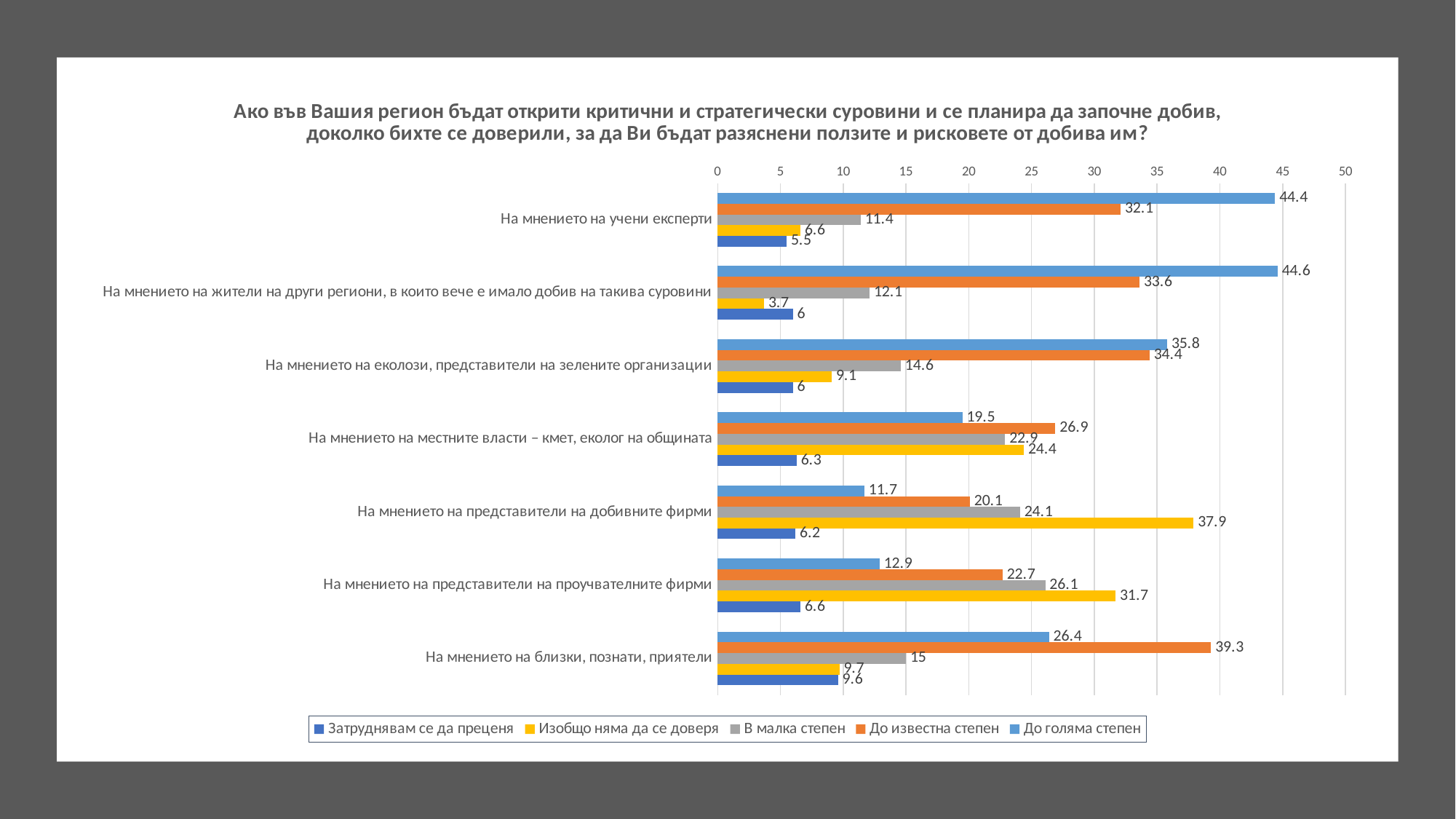
Which category has the highest value for the "До голяма степен" series? На мнението на жители на други региони, в които вече е имало добив на такива суровини Is the "До голяма степен" value for "На мнението на еколози, представители на зелените организации" greater or less than 30? greater How many series does the legend list? 5 What type of chart is shown on the slide? bar chart What is the difference between the "До голяма степен" and "До известна степен" values for "На мнението на учени експерти"? 12.3 How many categories are shown on the chart? 7 What is the value of "До голяма степен" for "На мнението на учени експерти"? 44.4 What is the value of "До известна степен" for "На мнението на близки, познати, приятели"? 39.3 Which category has the lowest value for the "Изобщо няма да се доверя" series? На мнението на жители на други региони, в които вече е имало добив на такива суровини What is the value of "Изобщо няма да се доверя" for "На мнението на представители на добивните фирми"? 37.9 What is the value of "Затруднявам се да преценя" for "На мнението на близки, познати, приятели"? 9.6 For "На мнението на местните власти – кмет, еколог на общината", which is larger: "До известна степен" or "Изобщо няма да се доверя"? До известна степен